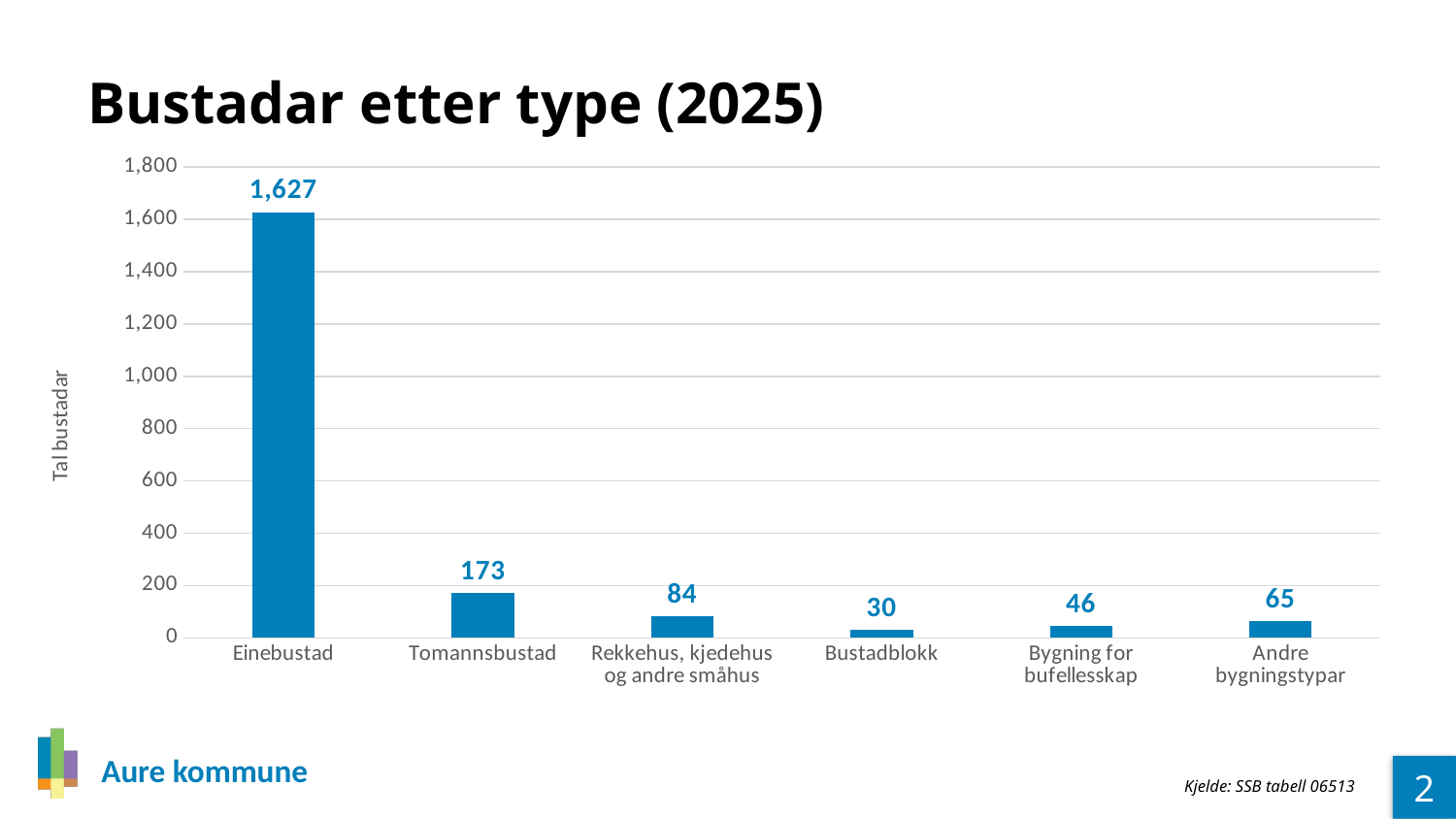
What is the value for Andre bygningstypar? 65 Which category has the lowest value? Bustadblokk What kind of chart is shown on the slide? Bar chart What is the title of the chart? Bustadar etter type (2025) What is the difference between the values for Einebustad and Tomannsbustad? 1,454 What is the value for Tomannsbustad? 173 What is the value for Bustadblokk? 30 What is the difference between the values for Andre bygningstypar and Bygning for bufellesskap? 19 What is the value for Einebustad? 1,627 Which is larger, the value for Rekkehus, kjedehus og andre småhus or the value for Bygning for bufellesskap? Rekkehus, kjedehus og andre småhus Which category has the highest value? Einebustad How many categories are shown on the x axis? 6